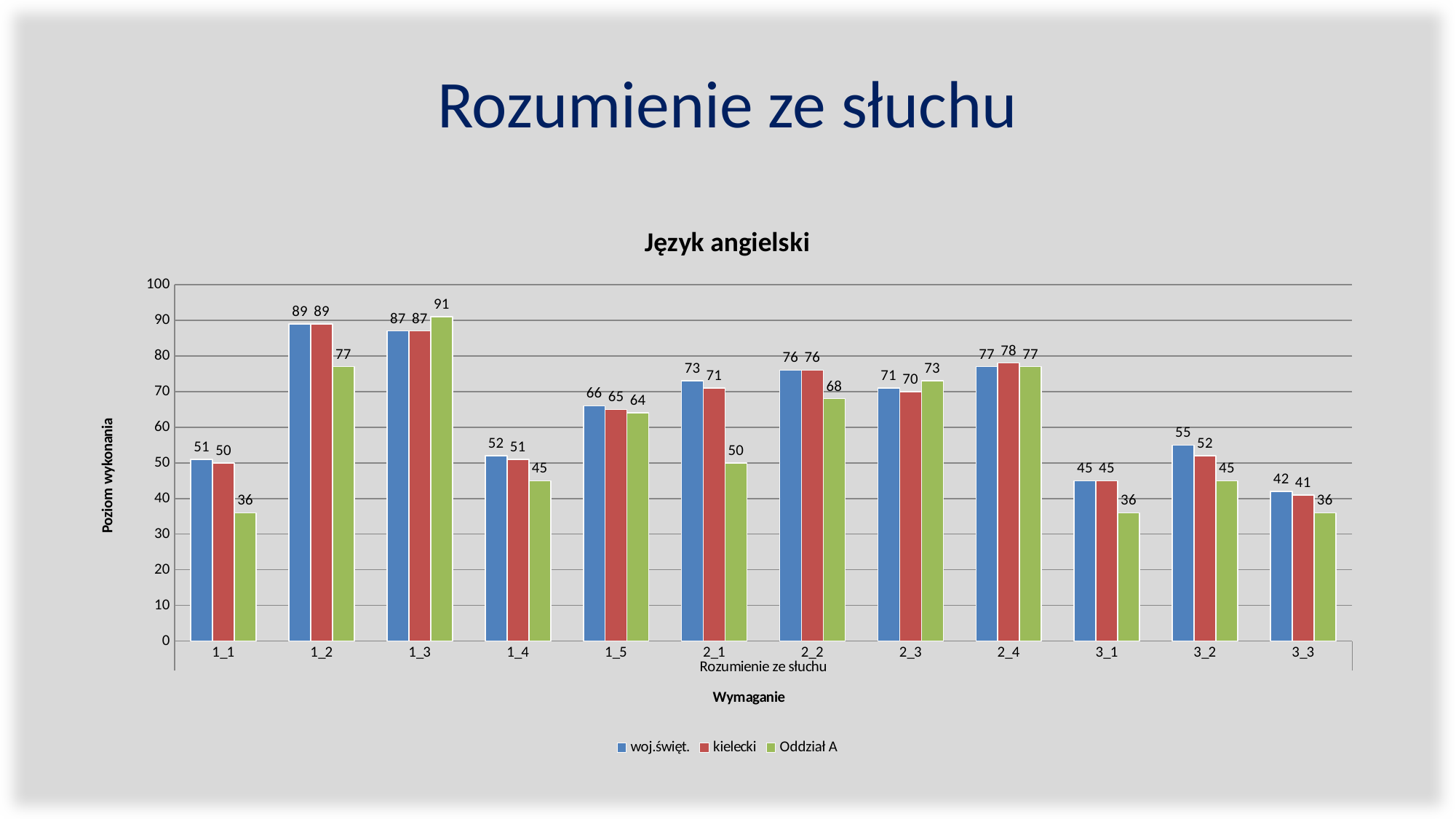
How many categories are shown on the x axis? 12 What is the value for woj.świet. in category 2_1? 73 Which is larger in category 1_2: the kielecki value or the Oddział A value? kielecki What is the title of the chart? Język angielski What kind of chart is shown on the slide? bar chart Which category has the highest value for woj.świet.? 1_2 What is the label of the y axis? Poziom wykonania What is the difference between the woj.świet. and Oddział A values in category 2_1? 23 Which category has the lowest value for Oddział A? 1_1 and 3_1 and 3_3 (36) What is the value for Oddział A in category 1_3? 91 What is the value for kielecki in category 3_2? 52 How many series does the legend list? 3